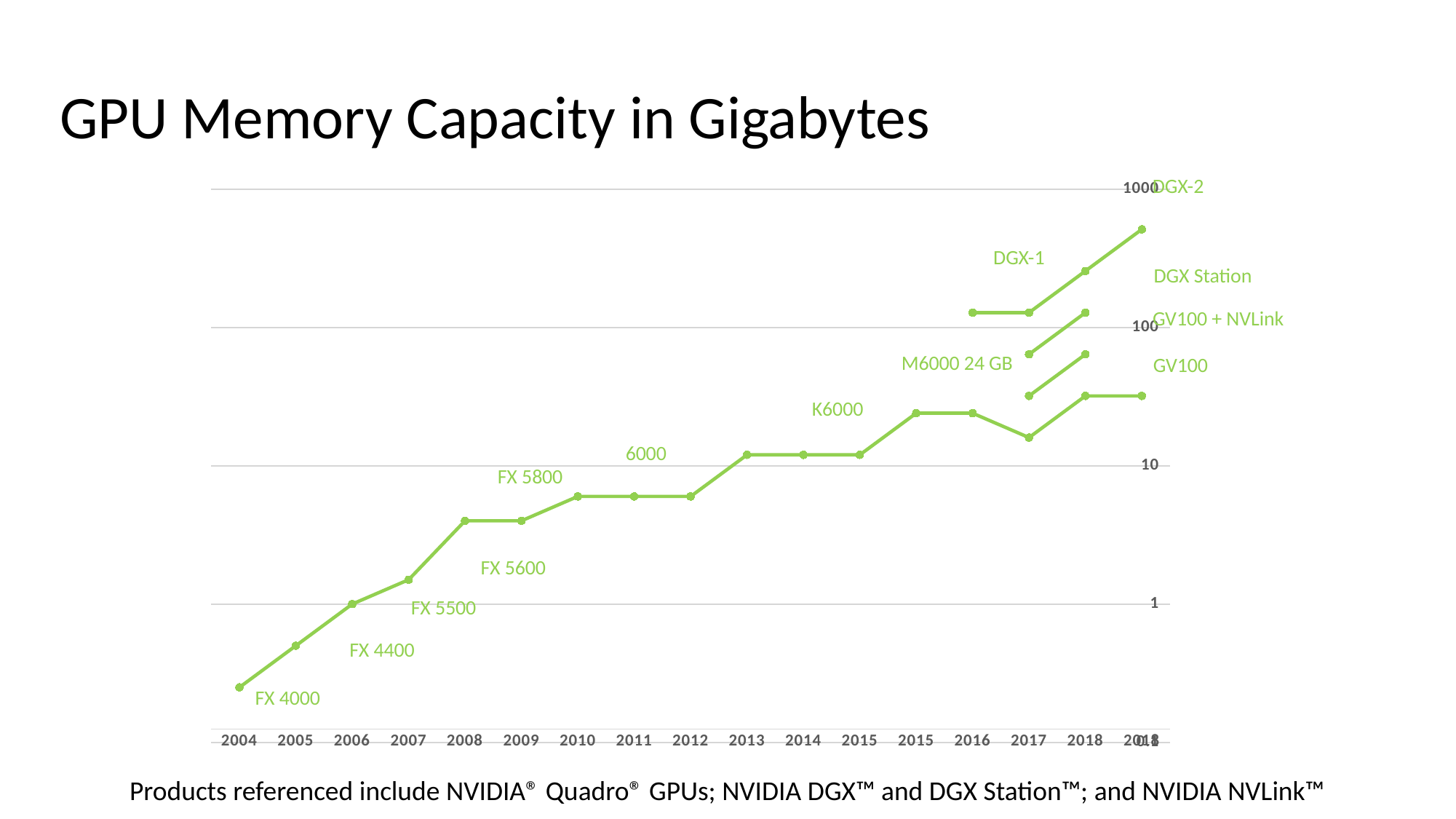
Which product has the lowest plotted memory capacity on the chart? FX 4000 Which has the larger memory capacity, DGX-1 or K6000? DGX-1 Is the value for DGX-1 in 2016 greater or less than 100? greater Is the value for K6000 in 2013 greater or less than 10? greater What kind of chart is shown on the slide? line chart Is the value for FX 5500 in 2007 greater or less than 1? greater What is the title of the chart? GPU Memory Capacity in Gigabytes Do the plotted memory capacities generally rise or fall from 2004 to 2018? rise Which product has the highest plotted memory capacity on the chart? DGX-2